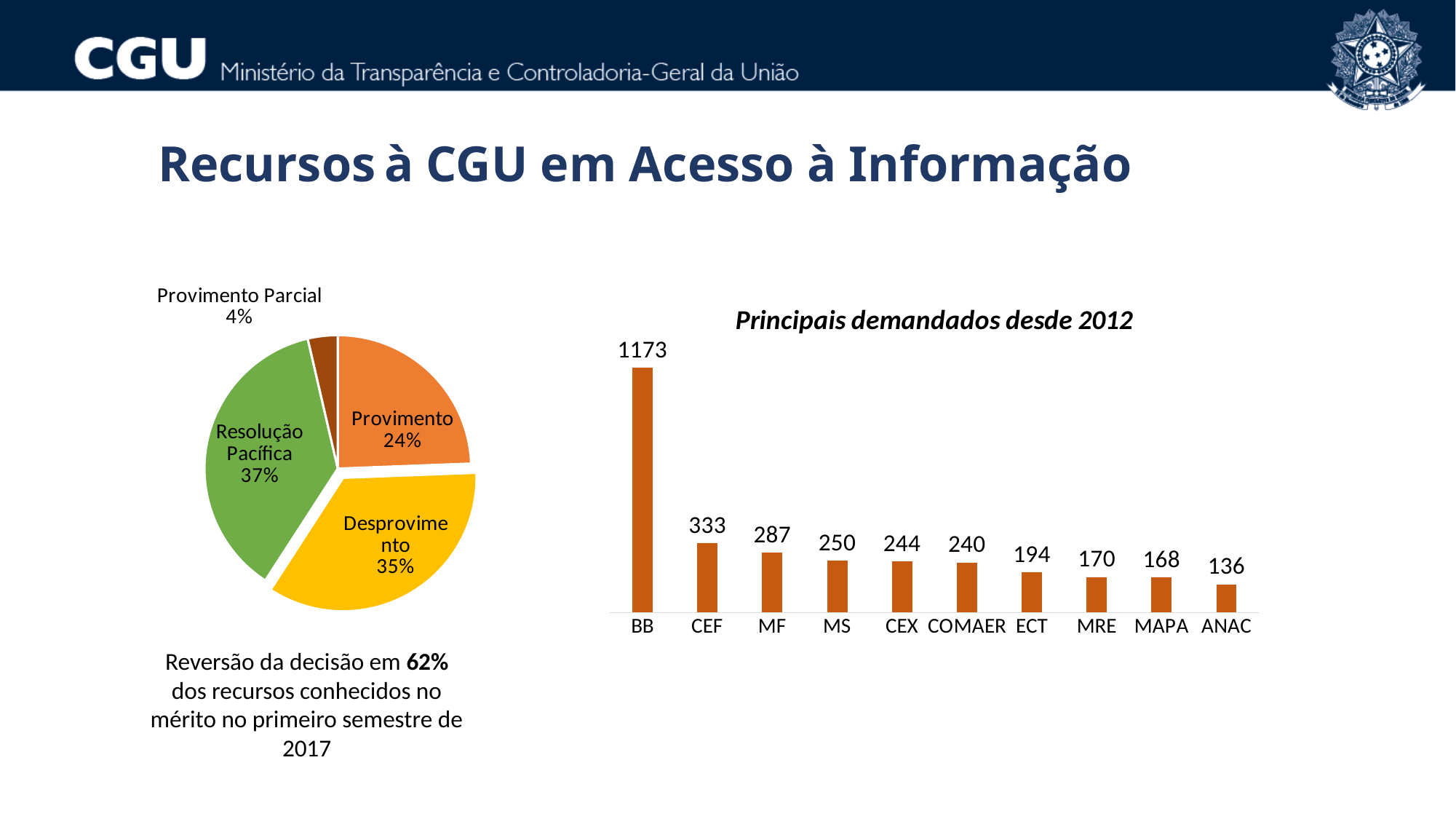
In the bar chart 'Principais demandados desde 2012', what is the difference between the values for CEF and MF? 46 In the bar chart 'Principais demandados desde 2012', which category has the lowest value? ANAC In the bar chart 'Principais demandados desde 2012', which category has the highest value? BB In the bar chart 'Principais demandados desde 2012', what is the value for BB? 1173 In the bar chart 'Principais demandados desde 2012', how many categories are shown? 10 In the pie chart on the left, how many slices are there? 4 In the pie chart on the left, what share does 'Resolução Pacífica' have? 37% What kind of chart is the chart on the left of the slide? pie chart In the bar chart 'Principais demandados desde 2012', which is larger, the value for MS or the value for ECT? MS In the bar chart 'Principais demandados desde 2012', do the values rise or fall from left to right? fall In the bar chart 'Principais demandados desde 2012', what is the value for COMAER? 240 In the pie chart on the left, which slice is the smallest? Provimento Parcial